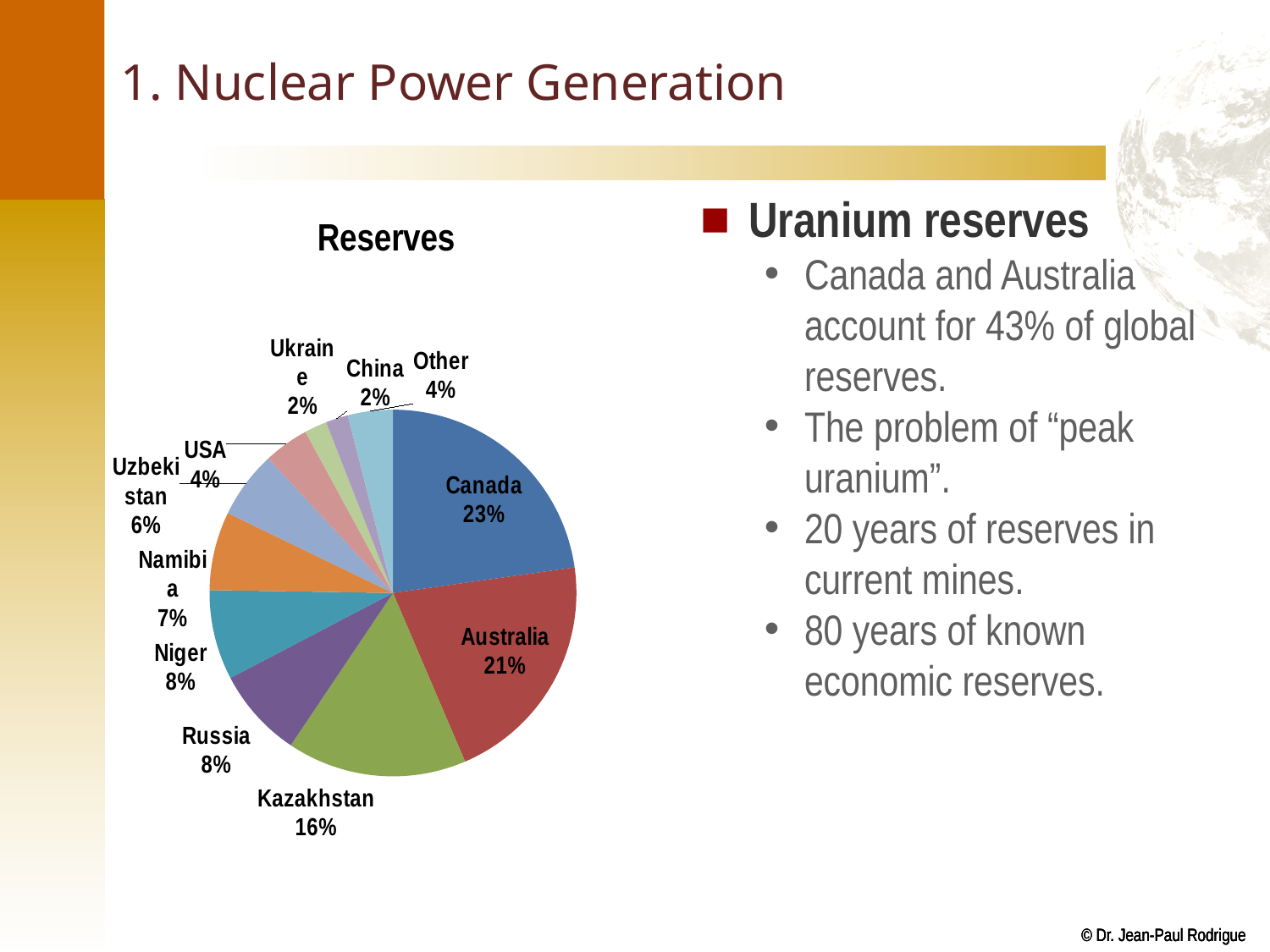
Which is larger, the share for Kazakhstan or the share for Russia? Kazakhstan What share of reserves does Uzbekistan hold? 6% What is the combined share of Canada and Australia? 44% What is the title of the chart? Reserves Which country has the largest share of reserves? Canada What share of reserves does Kazakhstan hold? 16% How many slices does the pie chart have? 11 What share of reserves does Canada hold? 23% What share of reserves is labelled 'Other'? 4% What is the difference between Canada's and Australia's shares of reserves? 2% What share of reserves does Namibia hold? 7% What type of chart is shown on the slide? pie chart